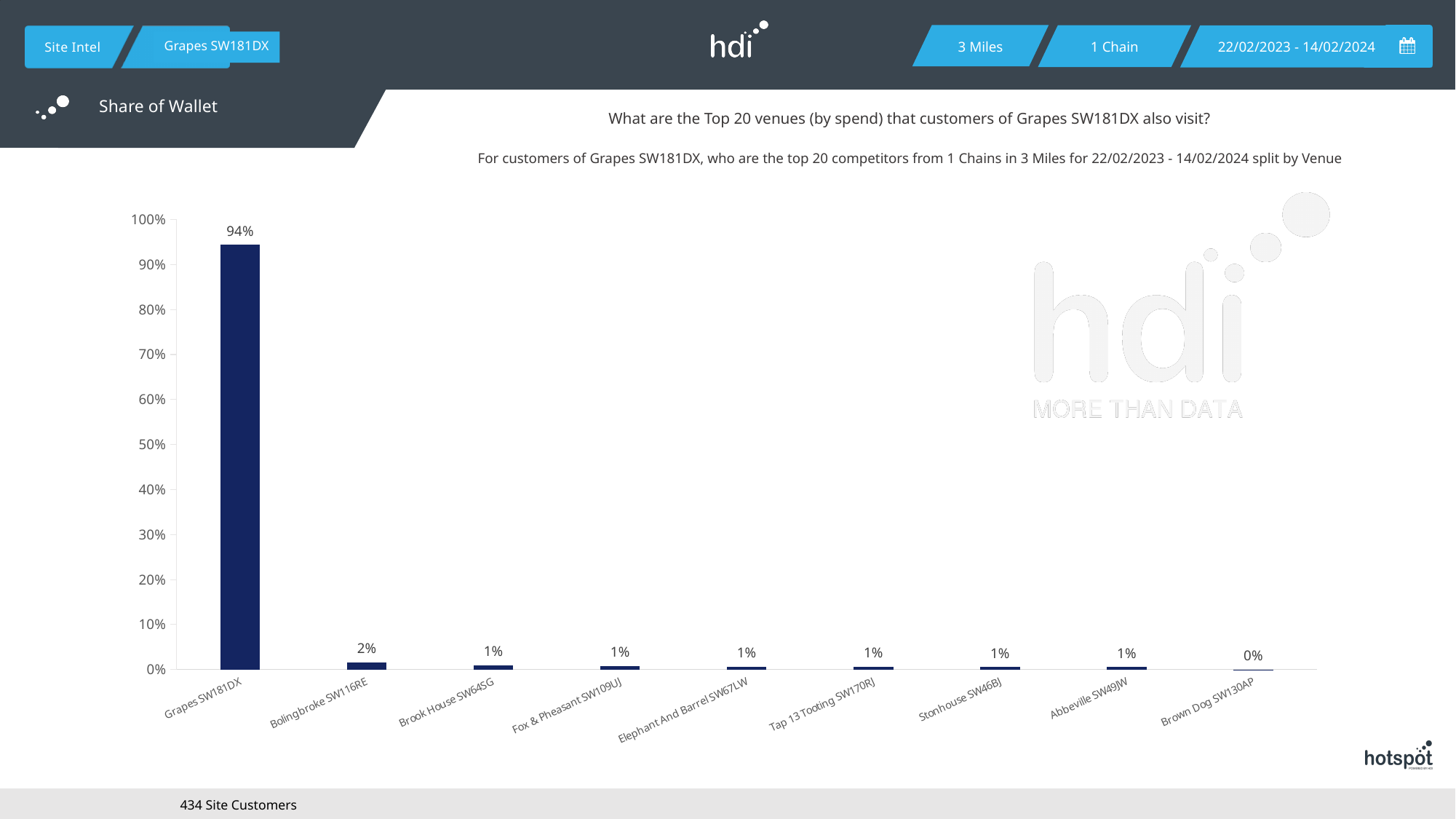
What is the value for Bolingbroke SW116RE? 2% Is the value for Grapes SW181DX greater or less than 90%? greater How many venues are shown on the x axis? 9 What is the value for Brown Dog SW130AP? 0% Which venue has the lowest value? Brown Dog SW130AP Which is larger, the value for Bolingbroke SW116RE or the value for Brook House SW64SG? Bolingbroke SW116RE What is the difference between the values for Grapes SW181DX and Bolingbroke SW116RE? 92% How many site customers are stated at the bottom of the slide? 434 What kind of chart is shown? bar chart Which venue has the highest value? Grapes SW181DX What is the value for Grapes SW181DX? 94% What is the value for Stonhouse SW46BJ? 1%